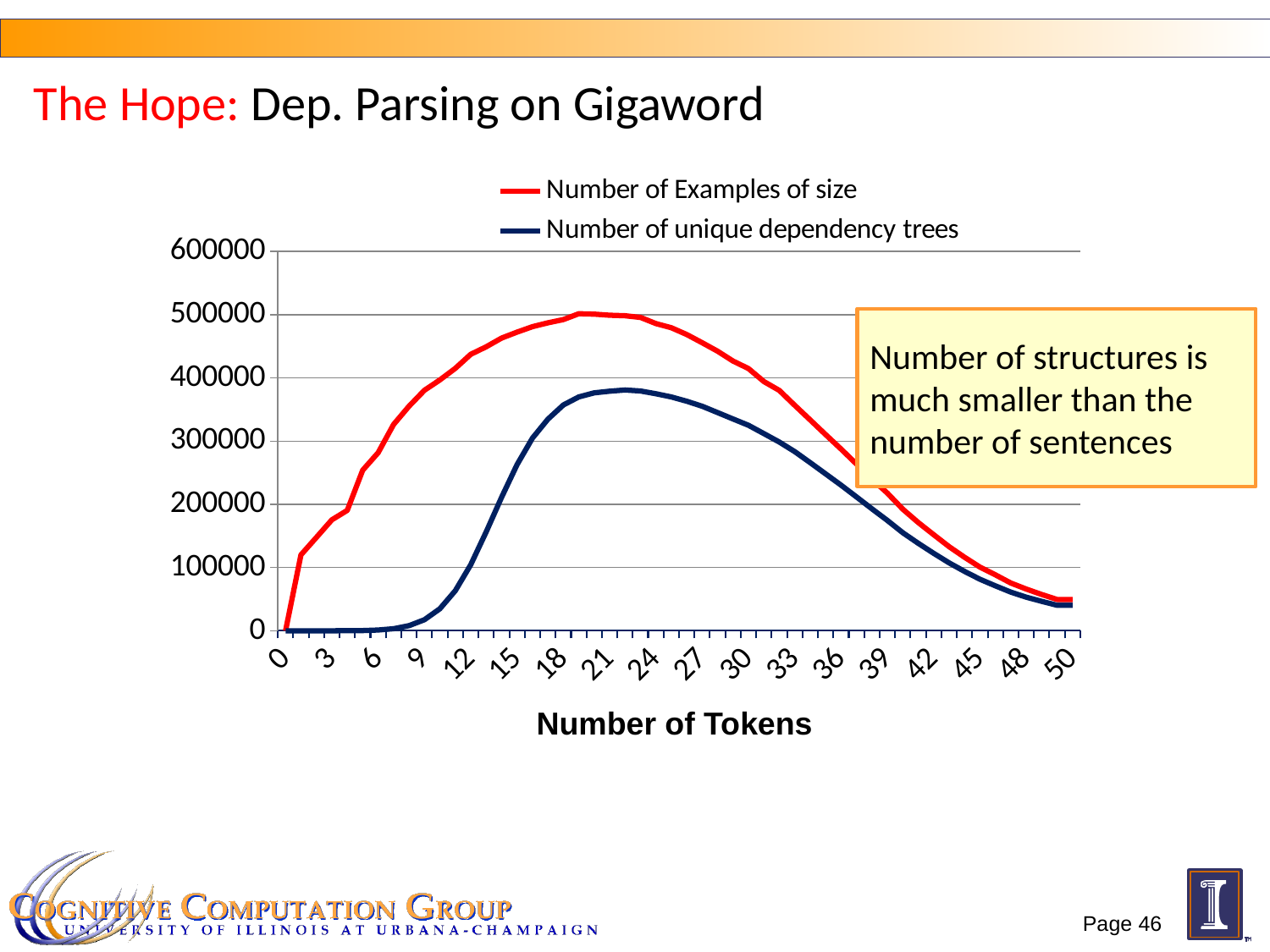
What is the title of the x axis? Number of Tokens Does the Number of Examples of size series rise or fall between 24 and 50 tokens? fall Is the value of Number of Examples of size at 48 tokens greater or less than 100000? less Which series reaches the higher peak value? Number of Examples of size What kind of chart is shown on the slide? line chart Is the value of Number of Examples of size at 3 tokens greater or less than 100000? greater Is the value of Number of Examples of size at 9 tokens greater or less than 300000? greater Which series is drawn in red? Number of Examples of size At 21 tokens, which series has the larger value: Number of Examples of size or Number of unique dependency trees? Number of Examples of size How many series does the legend list? 2